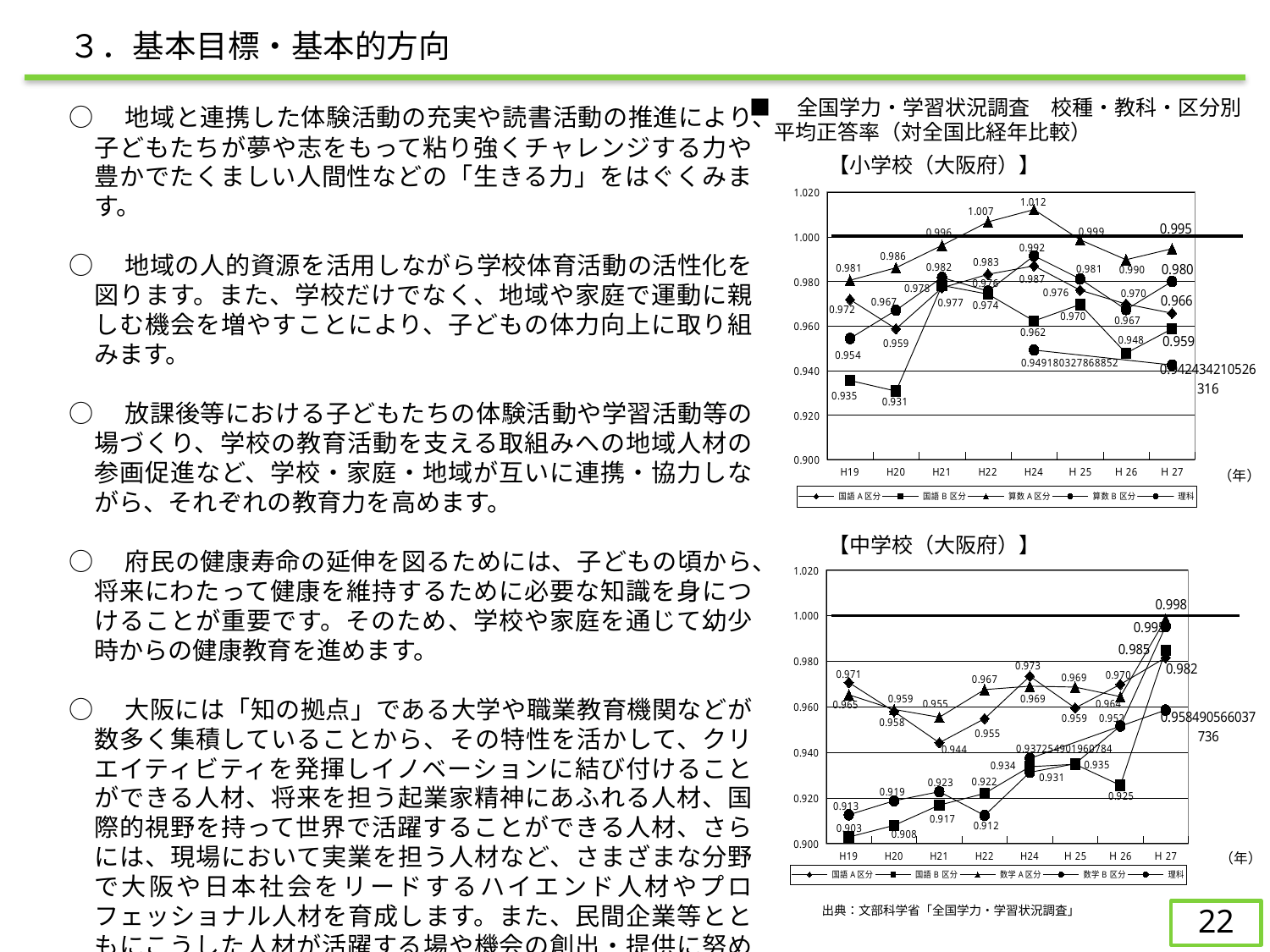
In the 【中学校（大阪府）】 chart, is the value for 国語B区分 at H19 greater or less than 0.920? less In the 【小学校（大阪府）】 chart, what is the highest value labelled on the chart? 1.012 What is the source cited below the charts? 文部科学省「全国学力・学習状況調査」 In the 【小学校（大阪府）】 chart, what is the lowest value labelled on the chart? 0.931 In the 【小学校（大阪府）】 chart, is the value for 算数A区分 at H24 greater or less than 1.000? greater In the 【中学校（大阪府）】 chart, what is the lowest value labelled on the chart? 0.903 How many years are shown on the x axis of the 【小学校（大阪府）】 chart? 8 In the 【中学校（大阪府）】 chart, does the 国語B区分 series generally rise or fall from H19 to H27? rise In the 【小学校（大阪府）】 chart, in which year does the highest labelled value (1.012) occur? H24 In the 【中学校（大阪府）】 chart, what is the highest value labelled on the chart? 0.998 What kind of chart is the 【小学校（大阪府）】 chart? line chart How many series does the legend of the 【中学校（大阪府）】 chart list? 5